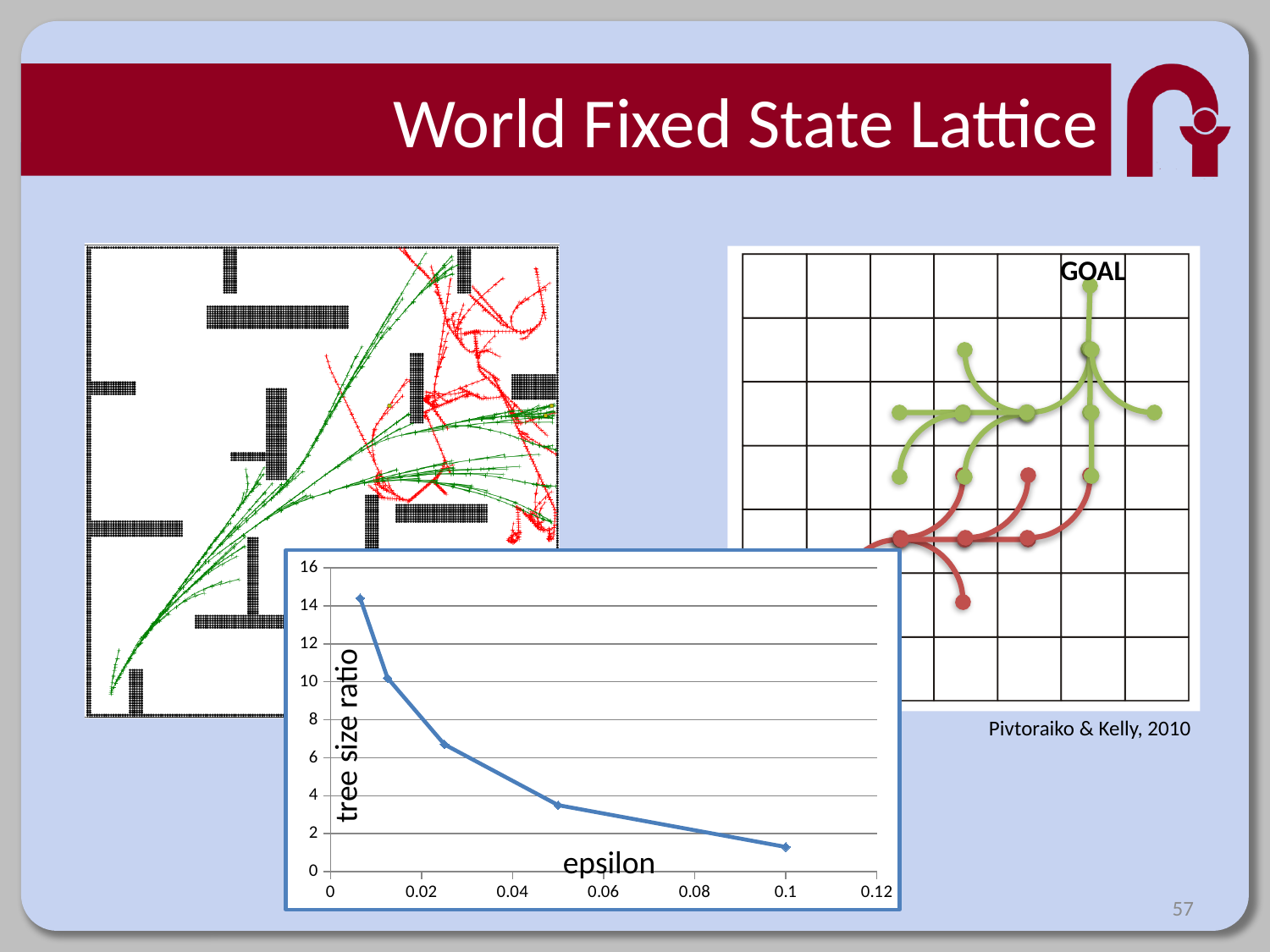
Which plotted point has the highest tree size ratio: the one with the smallest epsilon or the one with the largest epsilon? the one with the smallest epsilon Does the tree size ratio rise or fall as epsilon increases along the x axis? fall Is the tree size ratio at epsilon 0.025 greater or less than 6? greater What is the highest tick value shown on the y axis of the chart? 16 Is the tree size ratio at the smallest plotted epsilon greater or less than 12? greater How many data points are plotted on the chart? 5 Is the tree size ratio at epsilon 0.05 greater or less than 4? less Which is larger: the tree size ratio at epsilon 0.05 or at epsilon 0.1? at epsilon 0.05 What is the label of the y axis of the chart? tree size ratio What kind of chart is shown on the slide? line chart What is the label of the x axis of the chart? epsilon